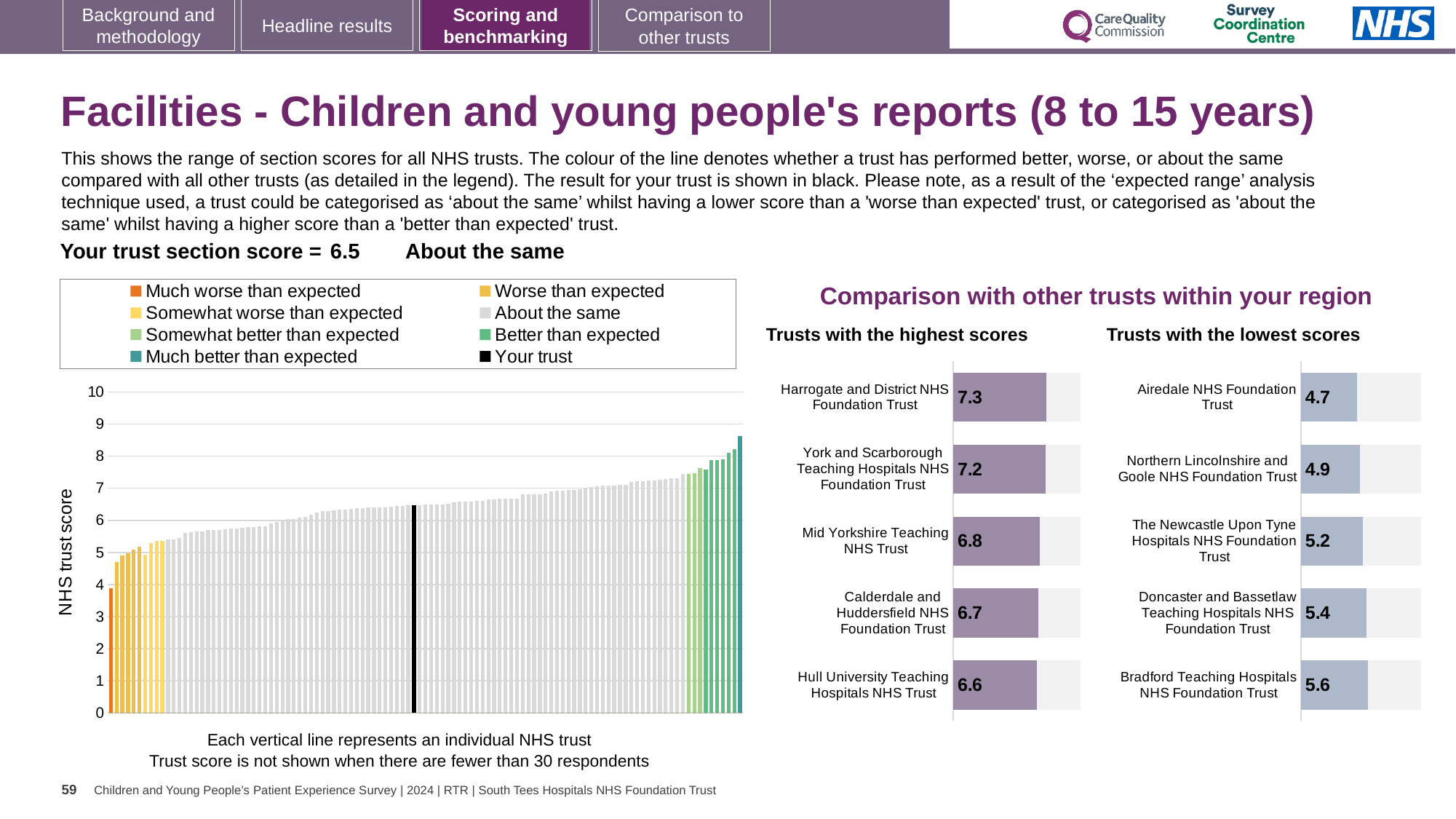
In the 'Trusts with the lowest scores' chart, what is the score for The Newcastle Upon Tyne Hospitals NHS Foundation Trust? 5.2 In the 'Trusts with the lowest scores' chart, what is the difference between the scores of Bradford Teaching Hospitals NHS Foundation Trust and Airedale NHS Foundation Trust? 0.9 In the 'Trusts with the highest scores' chart, what is the score for Harrogate and District NHS Foundation Trust? 7.3 In the 'Trusts with the lowest scores' chart, which has the higher score: Northern Lincolnshire and Goole NHS Foundation Trust or Doncaster and Bassetlaw Teaching Hospitals NHS Foundation Trust? Doncaster and Bassetlaw Teaching Hospitals NHS Foundation Trust How many entries does the legend above the NHS trust score chart list? 8 In the 'Trusts with the lowest scores' chart, which trust has the lowest score? Airedale NHS Foundation Trust How many trusts are listed in the 'Trusts with the highest scores' chart? 5 In the NHS trust score chart on the left, is the value of the tallest bar greater or less than 8? greater In the 'Trusts with the highest scores' chart, what is the difference between the scores of Harrogate and District NHS Foundation Trust and Hull University Teaching Hospitals NHS Trust? 0.7 In the 'Trusts with the highest scores' chart, which trust has the lowest score shown? Hull University Teaching Hospitals NHS Trust In the NHS trust score chart on the left, what is the score for your trust (the black bar)? 6.5 In the NHS trust score chart on the left, do the bar values rise or fall from left to right? rise